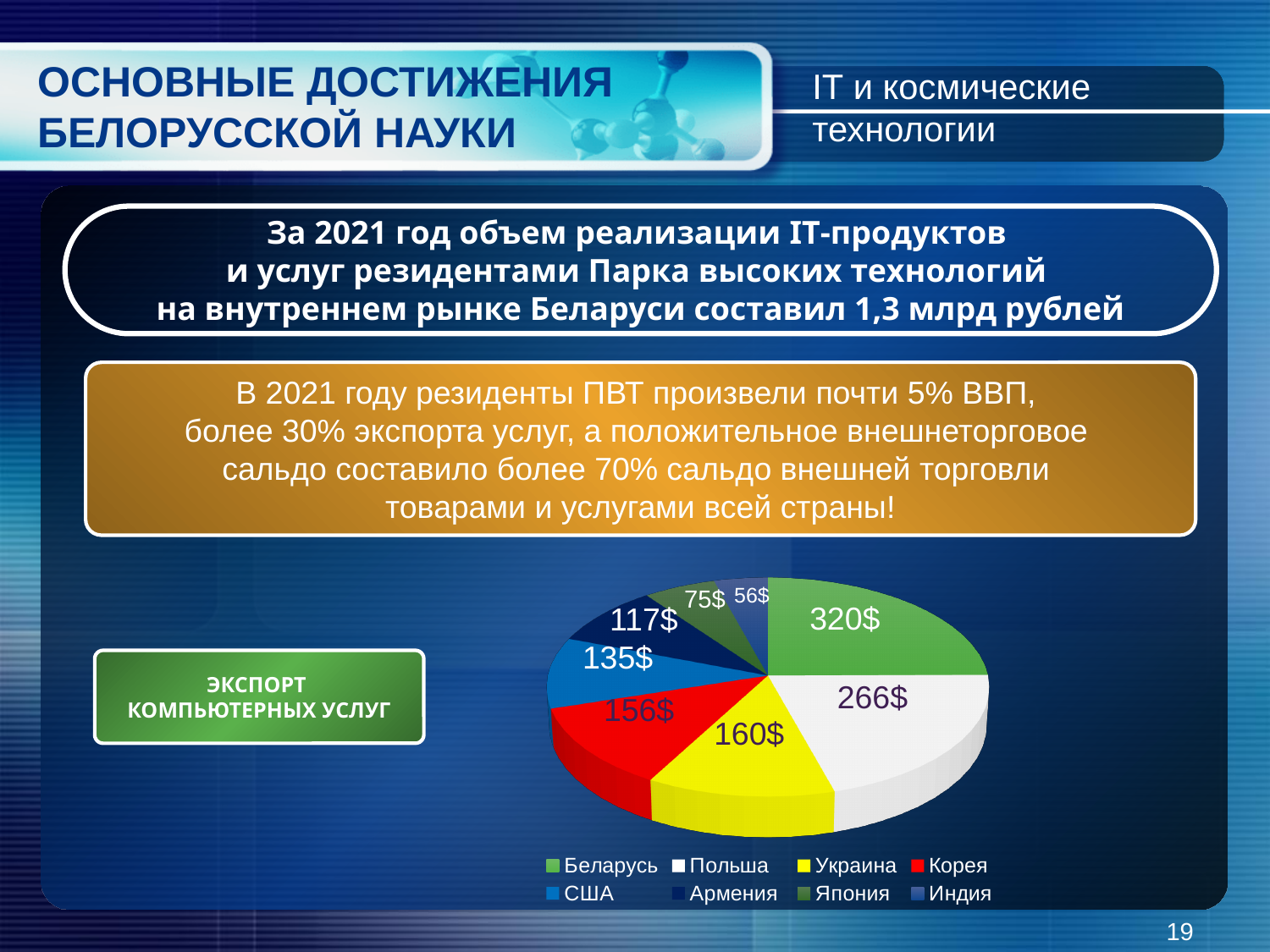
How many countries are listed in the pie chart legend? 8 Which country has the largest slice in the pie chart? Беларусь What colour is the slice for Украина in the pie chart? yellow Which is larger, the value for Украина or the value for Япония? Украина Which country has the smallest slice in the pie chart? Индия What is the value for Корея in the pie chart? 156$ What is the value for Беларусь in the pie chart? 320$ What is the difference between the values for США and Армения? 18$ What is the value for Индия in the pie chart? 56$ What is the value for Польша in the pie chart? 266$ What type of chart is shown on the slide? pie chart What is the difference between the values for Беларусь and Польша? 54$